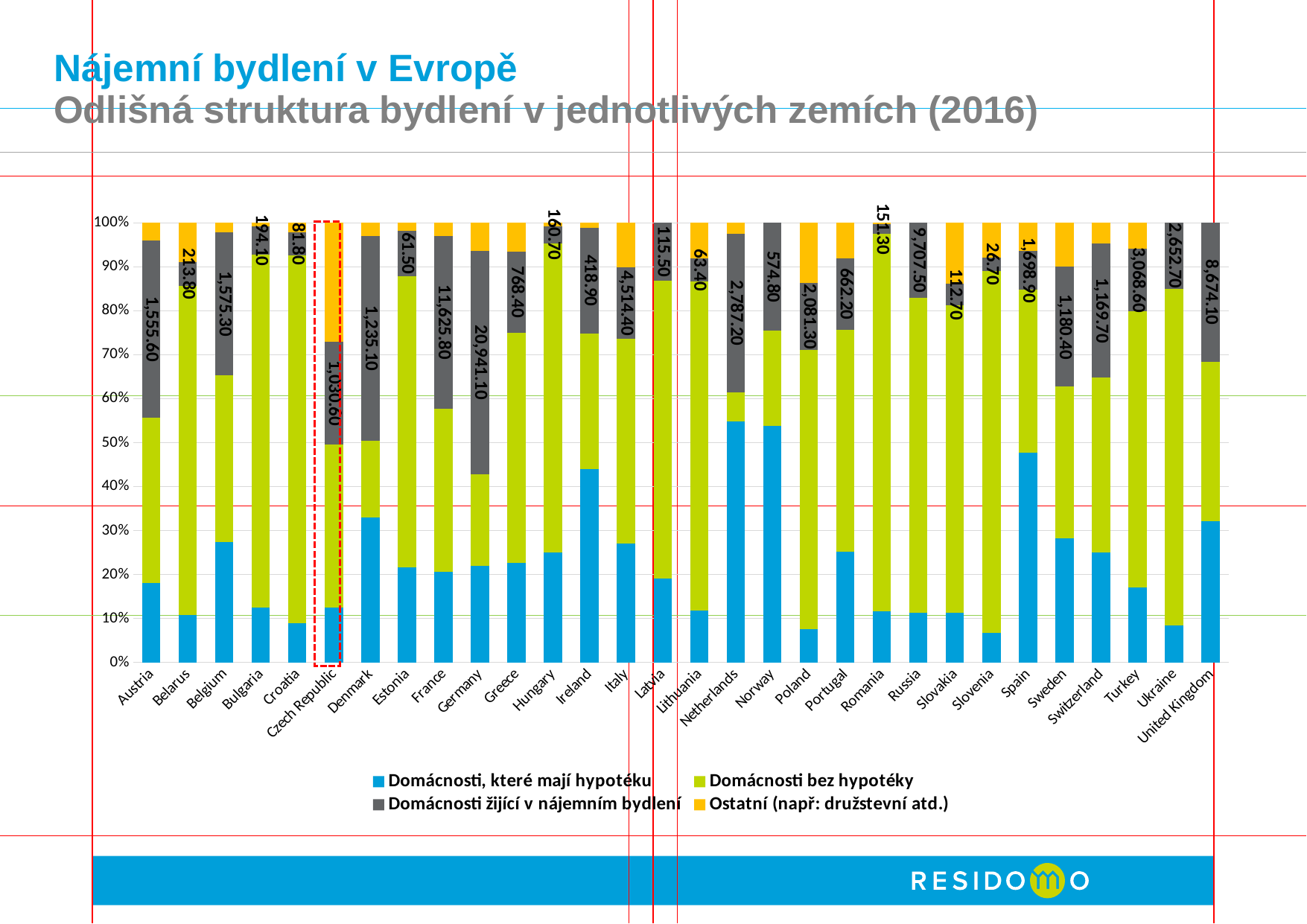
Is the share of 'Domácnosti, které mají hypotéku' (blue segment) for Netherlands greater or less than 50%? greater Which has the larger printed data label, Russia or United Kingdom? Russia How many countries are shown on the x axis of the chart? 30 What is the data label printed on the bar for United Kingdom? 8,674.10 How many series does the legend list? 4 What type of chart is shown on the slide? bar chart What is the data label printed on the bar for Czech Republic? 1,030.60 What is the difference between the printed data labels for Germany and France? 9,315.30 What is the data label printed on the bar for Germany? 20,941.10 Which country has the lowest printed data label? Slovenia Which country's bar is highlighted with a red dashed box? Czech Republic Which country has the highest printed data label? Germany